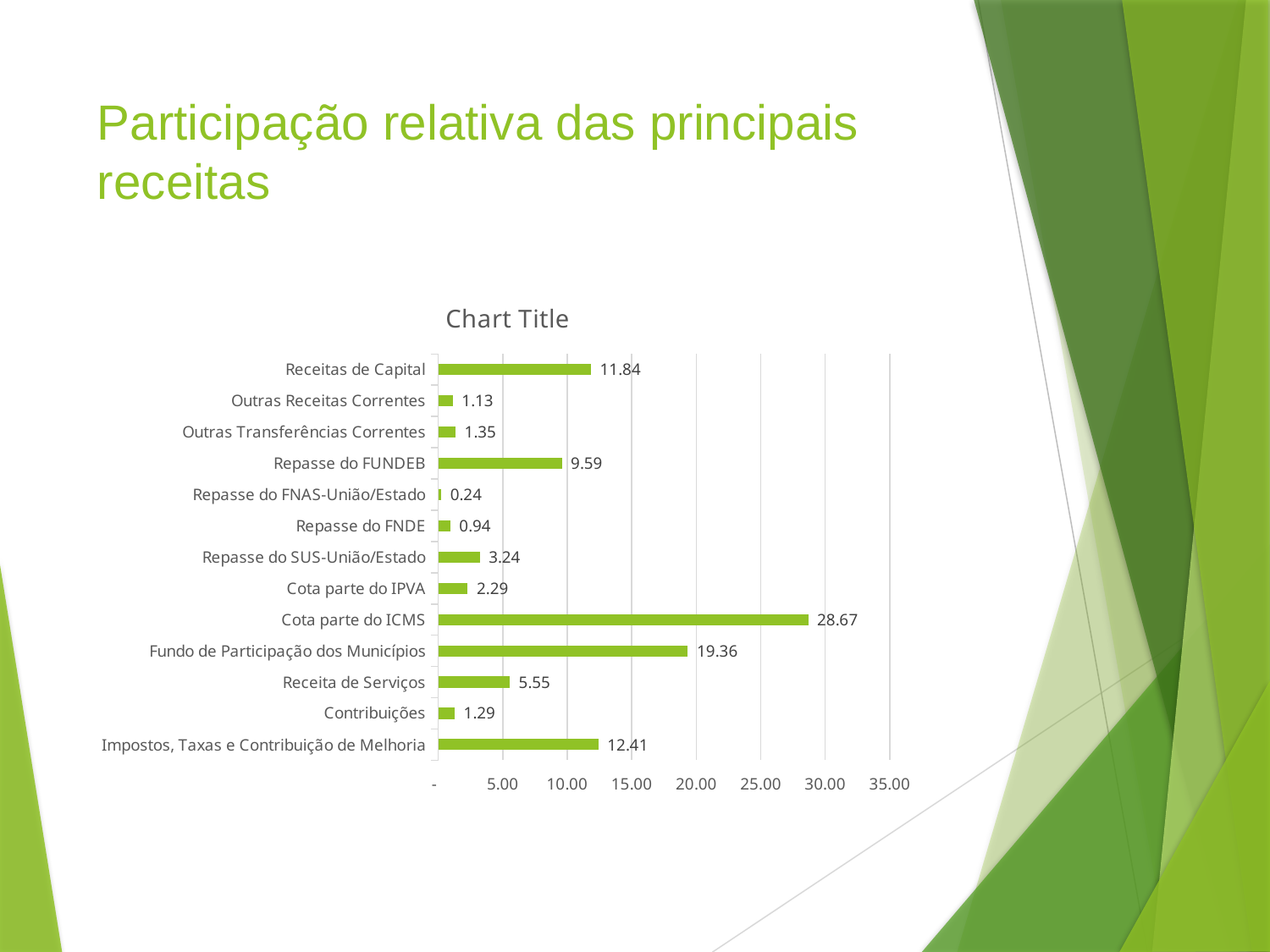
Which is larger, the value for Receitas de Capital or the value for Impostos, Taxas e Contribuição de Melhoria? Impostos, Taxas e Contribuição de Melhoria What kind of chart is shown on the slide? bar chart How many categories are shown in the chart? 13 Which category has the lowest value? Repasse do FNAS-União/Estado What is the value for Cota parte do ICMS? 28.67 What is the value for Impostos, Taxas e Contribuição de Melhoria? 12.41 Is the value for Fundo de Participação dos Municípios greater or less than 15.00? greater What is the title shown above the chart? Chart Title What is the difference between the values for Cota parte do ICMS and Fundo de Participação dos Municípios? 9.31 What is the value for Repasse do FUNDEB? 9.59 What is the value for Receita de Serviços? 5.55 Which category has the highest value? Cota parte do ICMS